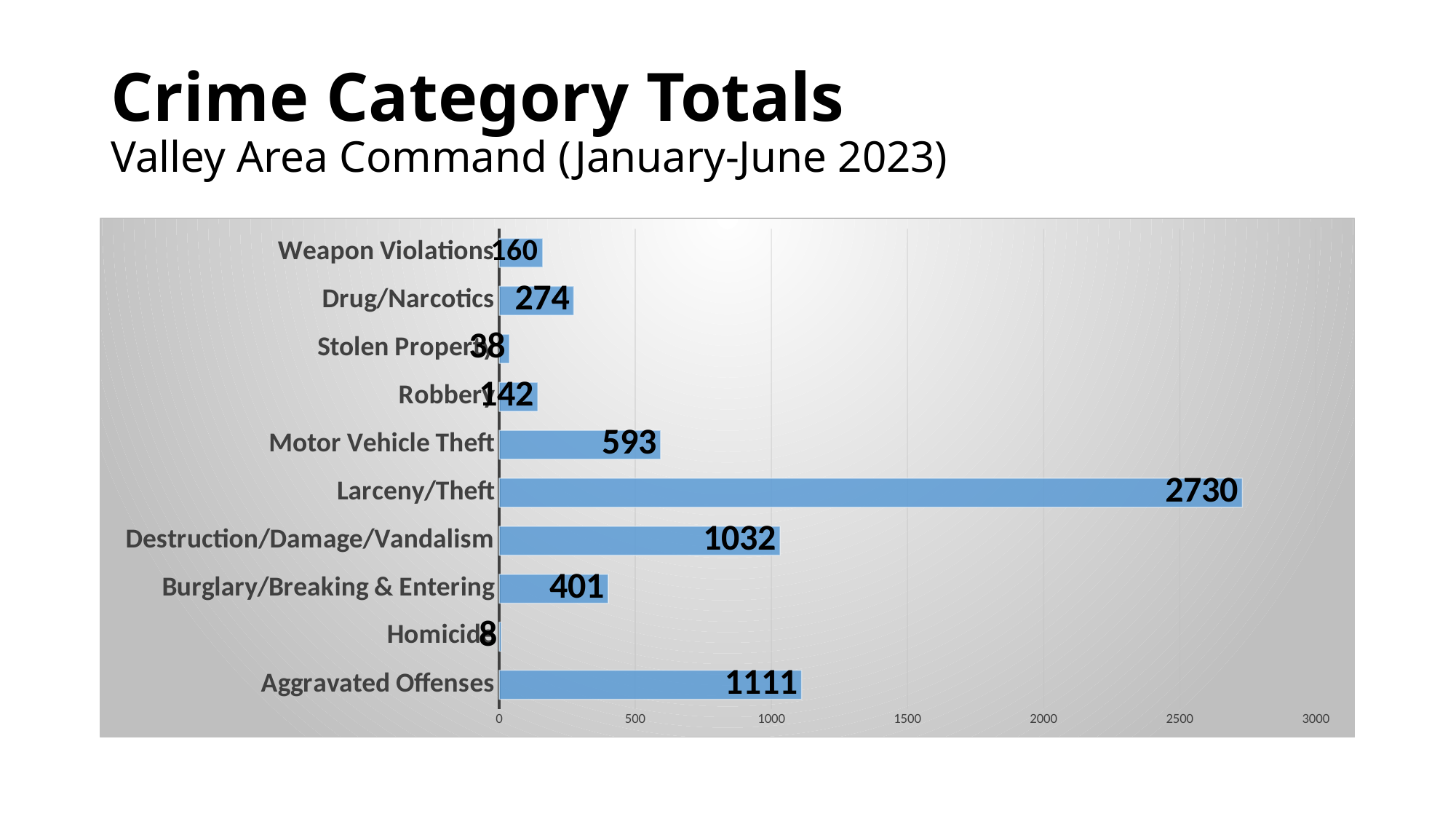
What is the difference between the values for Larceny/Theft and Aggravated Offenses? 1619 Which crime category has the lowest total? Homicide What is the value for Larceny/Theft? 2730 What is the value for Burglary/Breaking & Entering? 401 What is the title of the slide? Crime Category Totals Which is larger, the value for Drug/Narcotics or the value for Weapon Violations? Drug/Narcotics What is the value for Motor Vehicle Theft? 593 What kind of chart is shown on the slide? bar chart What is the difference between the values for Aggravated Offenses and Destruction/Damage/Vandalism? 79 How many crime categories are shown in the chart? 10 Is the value for Motor Vehicle Theft greater or less than 500? greater Which crime category has the highest total? Larceny/Theft